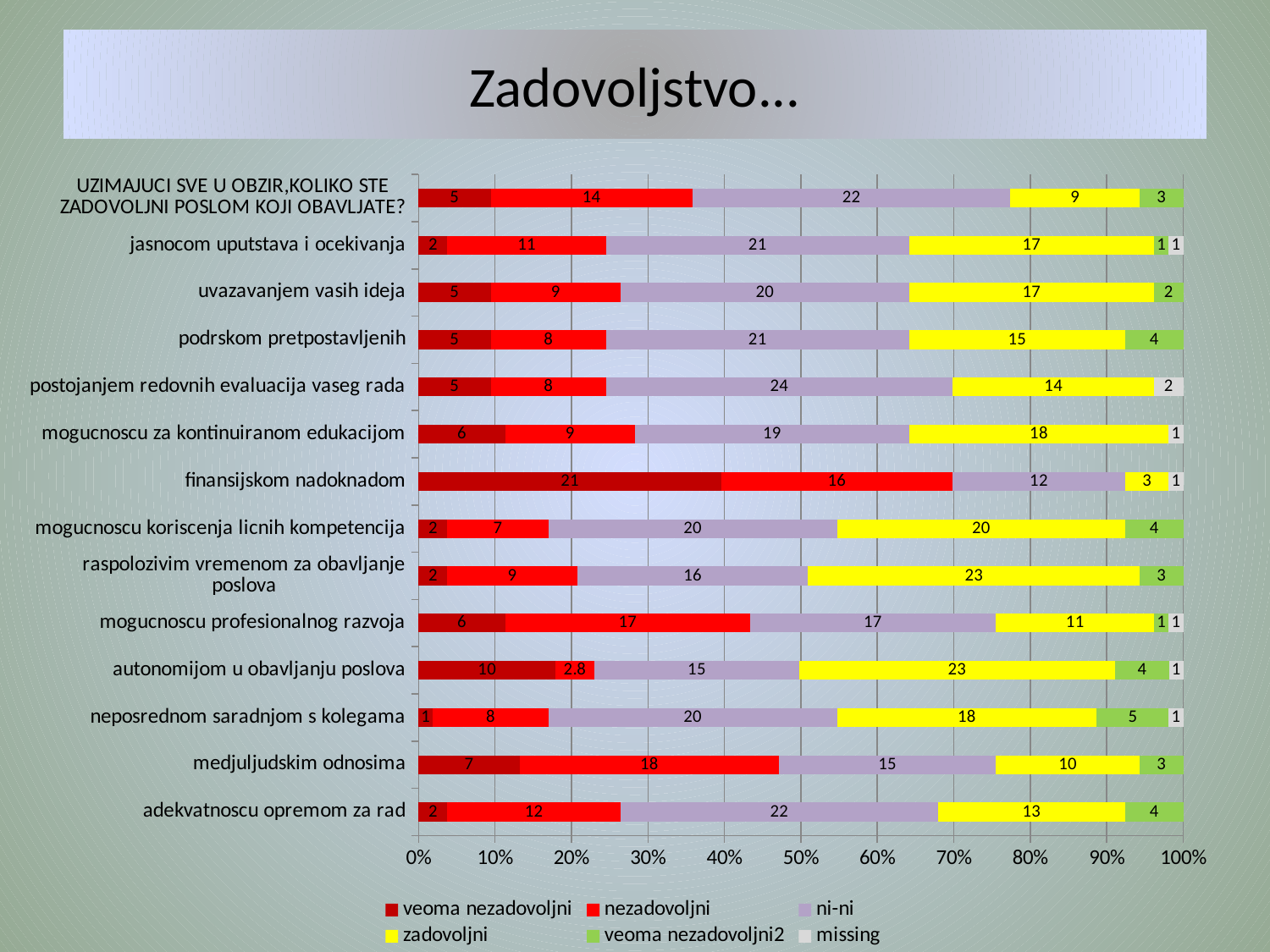
Which is larger: the 'zadovoljni' value for 'mogucnoscu koriscenja licnih kompetencija' or for 'adekvatnoscu opremom za rad'? mogucnoscu koriscenja licnih kompetencija What is the 'zadovoljni' value for 'raspolozivim vremenom za obavljanje poslova'? 23 Which category has the highest 'veoma nezadovoljni' value? finansijskom nadoknadom What is the title of the slide containing the chart? Zadovoljstvo... What is the 'veoma nezadovoljni2' value for 'neposrednom saradnjom s kolegama'? 5 What kind of chart is shown on the slide? stacked bar chart What is the 'nezadovoljni' value for 'autonomijom u obavljanju poslova'? 2.8 How many series does the legend list? 6 How many categories are plotted on the vertical axis? 14 What is the difference between the 'nezadovoljni' values for 'medjuljudskim odnosima' and 'neposrednom saradnjom s kolegama'? 10 What is the 'veoma nezadovoljni' value for 'finansijskom nadoknadom'? 21 What is the 'ni-ni' value for 'postojanjem redovnih evaluacija vaseg rada'? 24